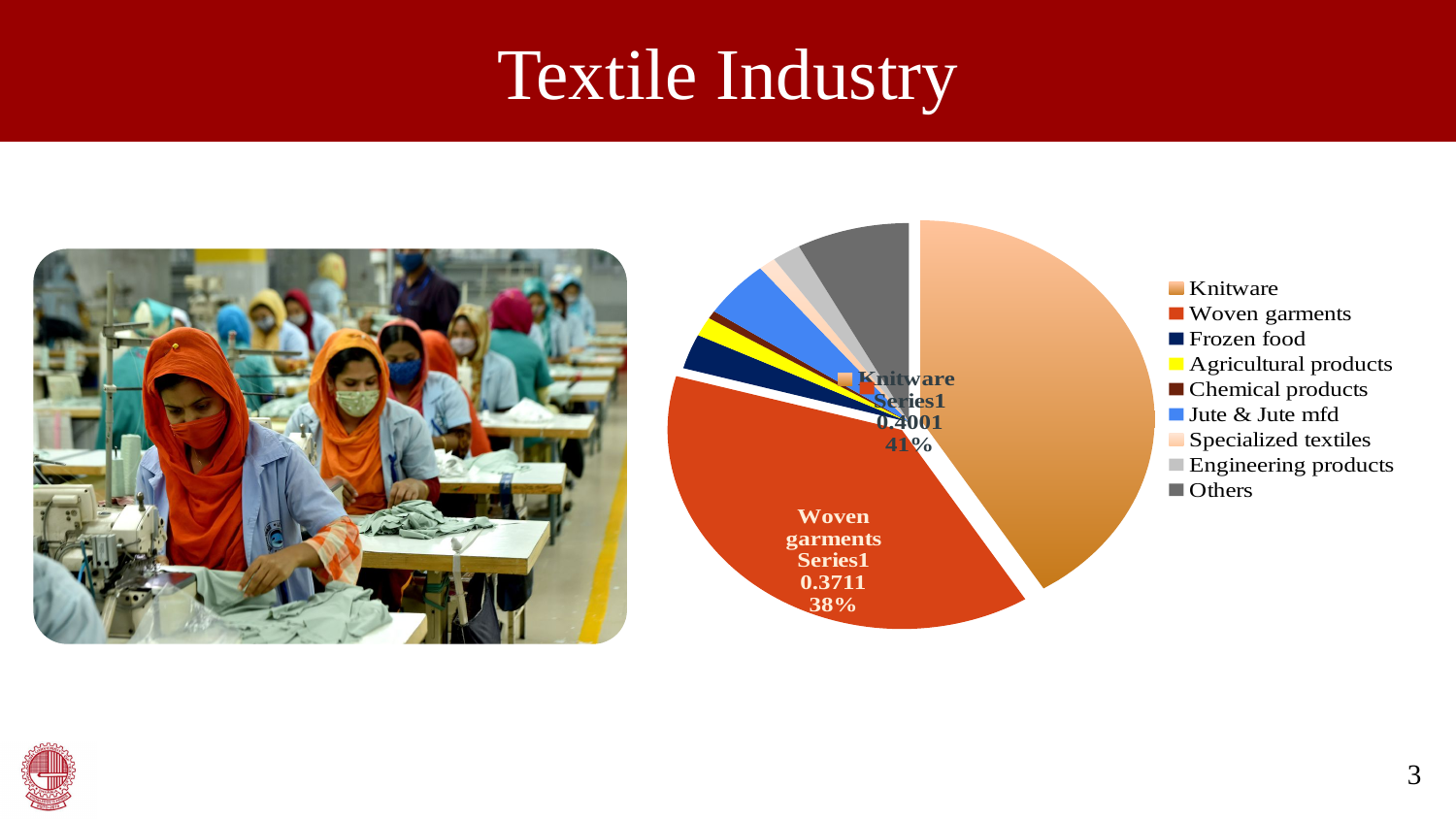
What value is printed on the Woven garments slice? 0.3711 What kind of chart is shown on the slide? Pie chart How many categories does the pie chart's legend list? 9 Which category is shown in yellow in the pie chart? Agricultural products What is the difference in percentage share between Knitware and Woven garments? 3% Which slice is larger, Woven garments or Frozen food? Woven garments Which category has the largest slice of the pie? Knitware Which slice is larger, Knitware or Woven garments? Knitware Which category is listed last in the pie chart's legend? Others What percentage share of the pie does Knitware have? 41% What value is printed on the Knitware slice? 0.4001 What percentage share of the pie does Woven garments have? 38%